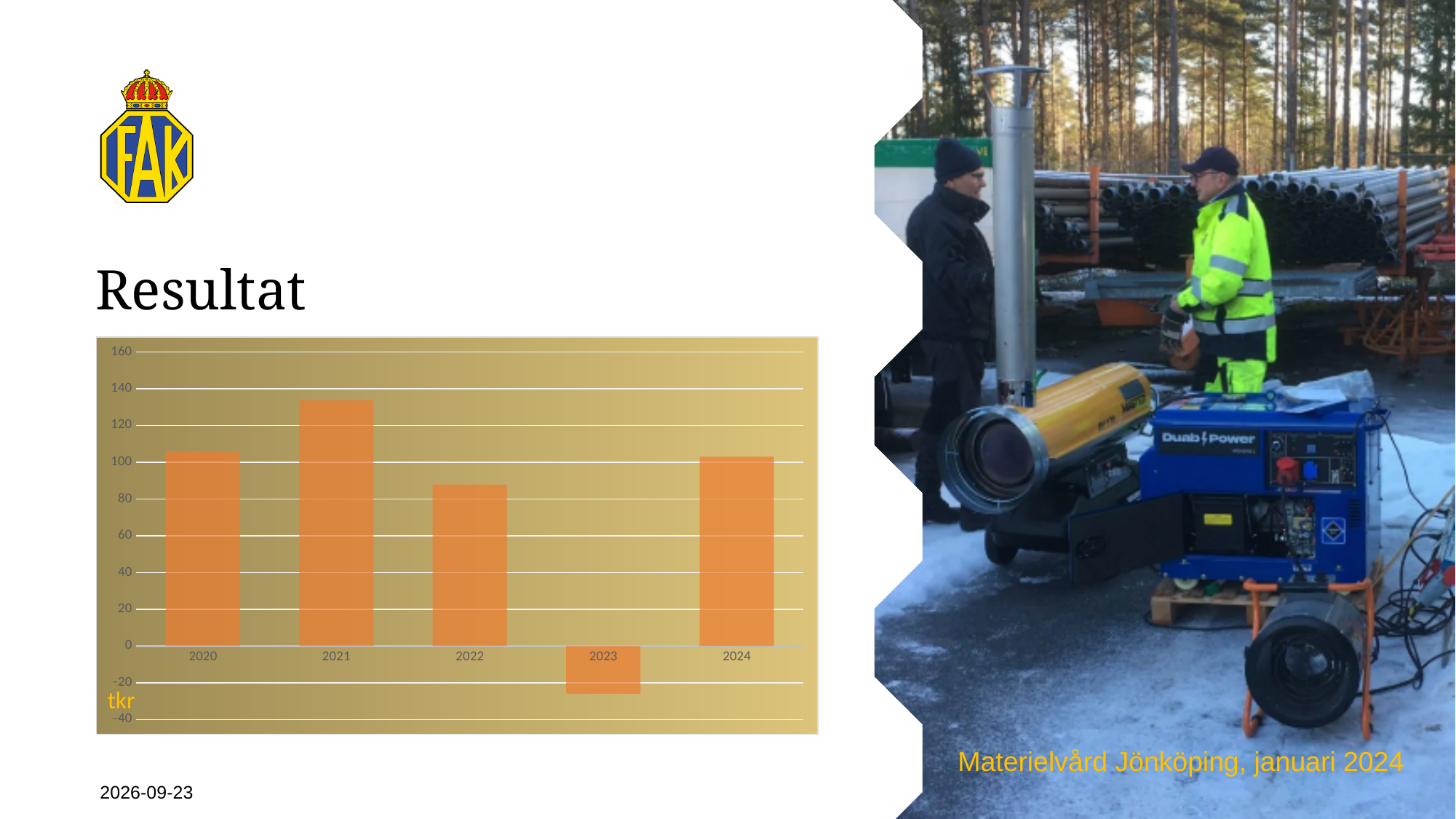
Which is larger, the value for 2021 or the value for 2022? 2021 What unit label is shown at the bottom left of the chart? tkr How many years are shown on the x axis of the chart? 5 What is the title of the slide containing the chart? Resultat Is the value for 2021 greater or less than 120? greater Is the value for 2022 greater or less than 100? less Which is larger, the value for 2020 or the value for 2022? 2020 Is the value for 2023 greater or less than 0? less What kind of chart is shown on the slide? bar chart Which year has the highest value in the chart? 2021 Which year has the lowest value in the chart? 2023